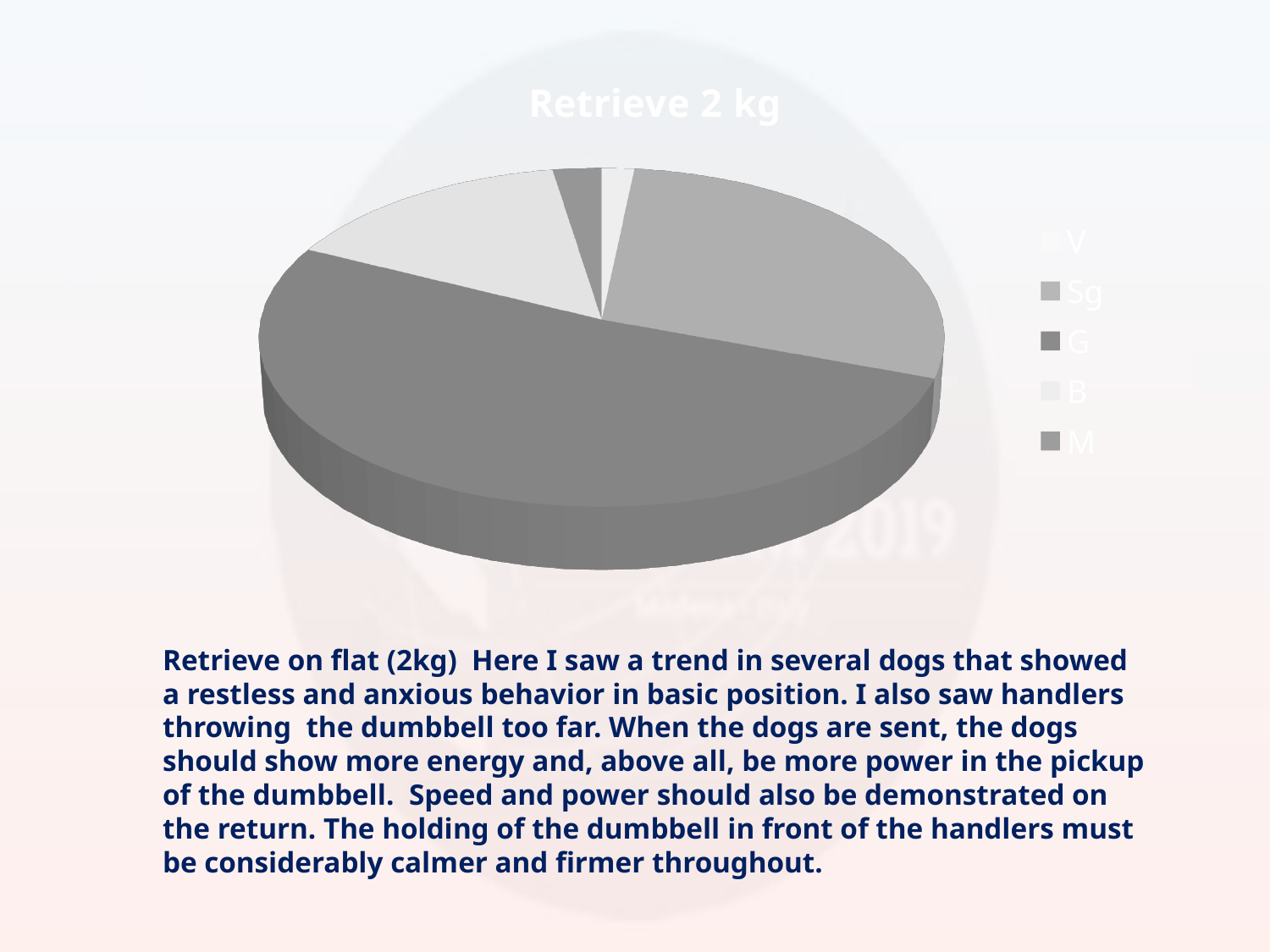
Which slice is larger, G or B? G Which slice is larger, Sg or M? Sg How many categories does the legend of the pie chart list? 5 What kind of chart is shown on the slide? pie chart Which slice is larger, G or Sg? G Which legend entry is listed first in the legend? V Which category has the largest slice of the pie? G What is the title of the chart? Retrieve 2 kg